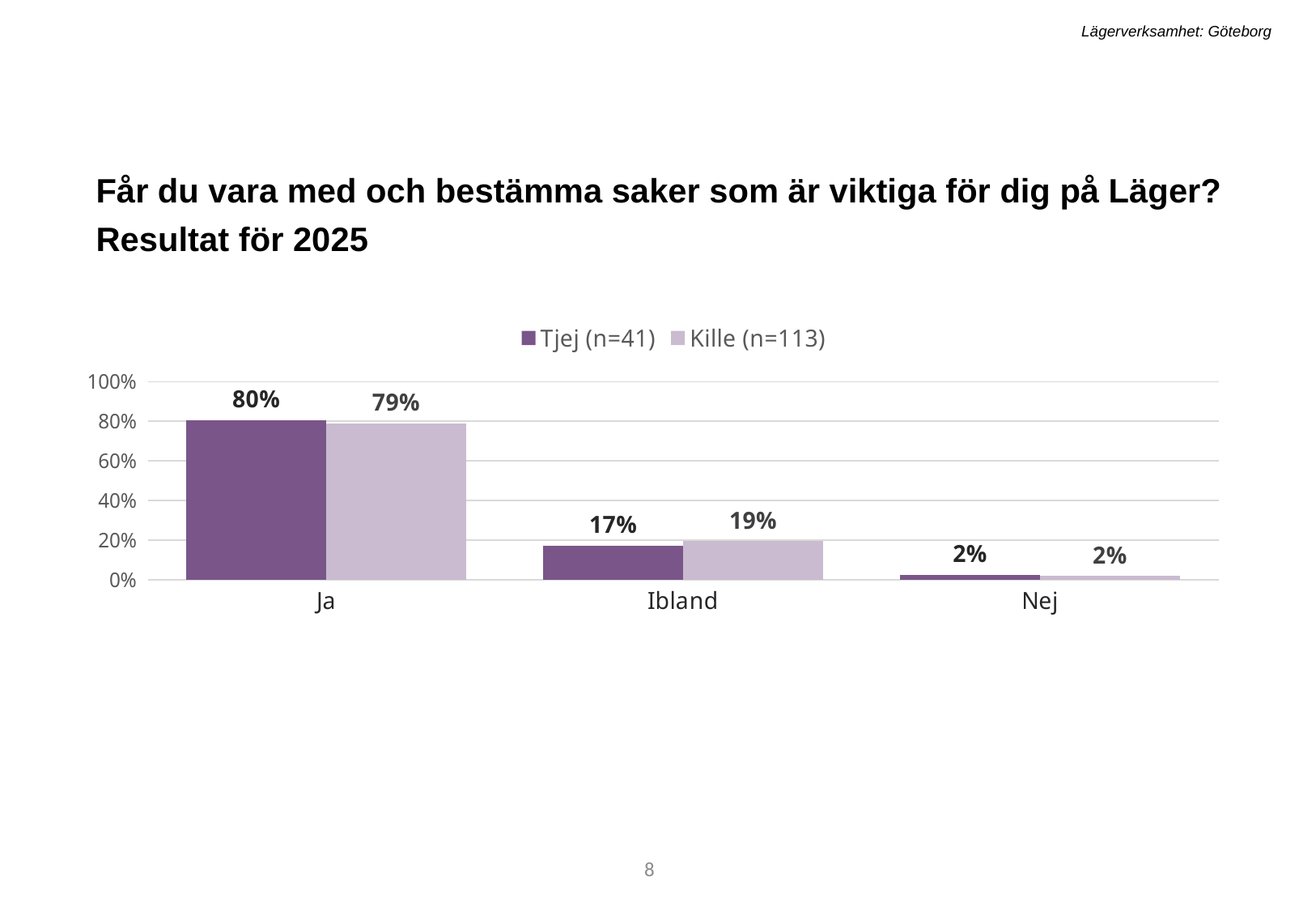
What is the difference between the Tjej (n=41) and Kille (n=113) values in the Ibland category? 2% Do the values for Kille (n=113) rise or fall from Ja to Nej along the x axis? Fall How many categories are shown on the x axis? 3 What is the difference between the Ja and Ibland values for Tjej (n=41)? 63% What is the value for Tjej (n=41) in the Nej category? 2% Which category has the highest value for Kille (n=113)? Ja What is the value for Tjej (n=41) in the Ja category? 80% How many series does the legend list? 2 What is the value for Kille (n=113) in the Ibland category? 19% Which category has the lowest value for Tjej (n=41)? Nej Which is larger in the Ibland category: Tjej (n=41) or Kille (n=113)? Kille (n=113) What kind of chart is shown on the slide? Bar chart